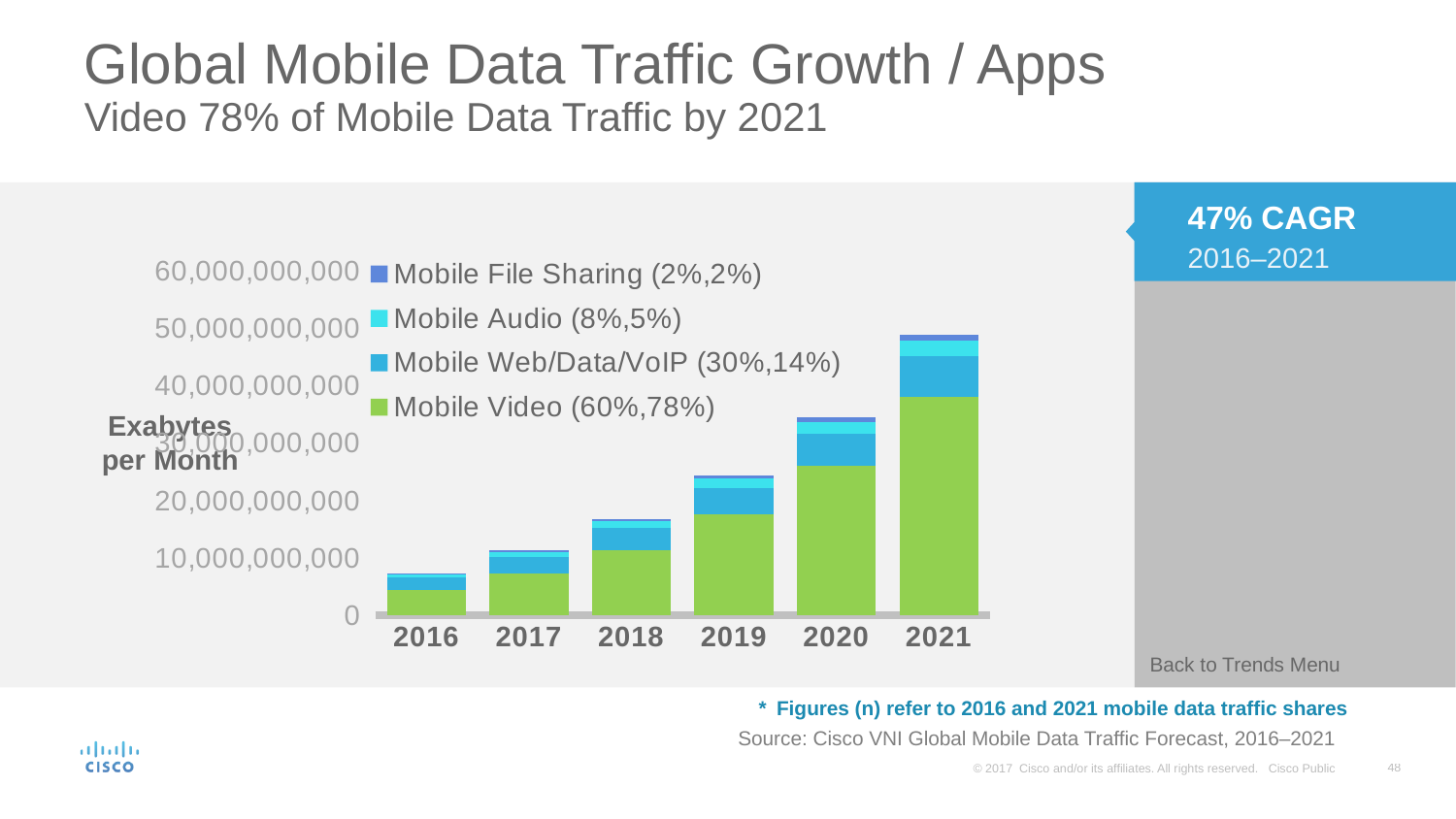
Do the total bar heights rise or fall from 2016 to 2021? Rise Is the total value for 2016 greater or less than 10,000,000,000? less Which series is the largest component of each bar in the chart? Mobile Video Is the total value for 2020 greater or less than 40,000,000,000? less How many series does the chart's legend list? 4 Which year has the highest total mobile data traffic in the chart? 2021 What unit does the y axis of the chart measure? Exabytes per Month Which year has the lowest total mobile data traffic in the chart? 2016 What kind of chart is shown on the slide? Stacked bar chart Is the total value for 2021 greater or less than 40,000,000,000? greater How many years are shown on the x axis of the chart? 6